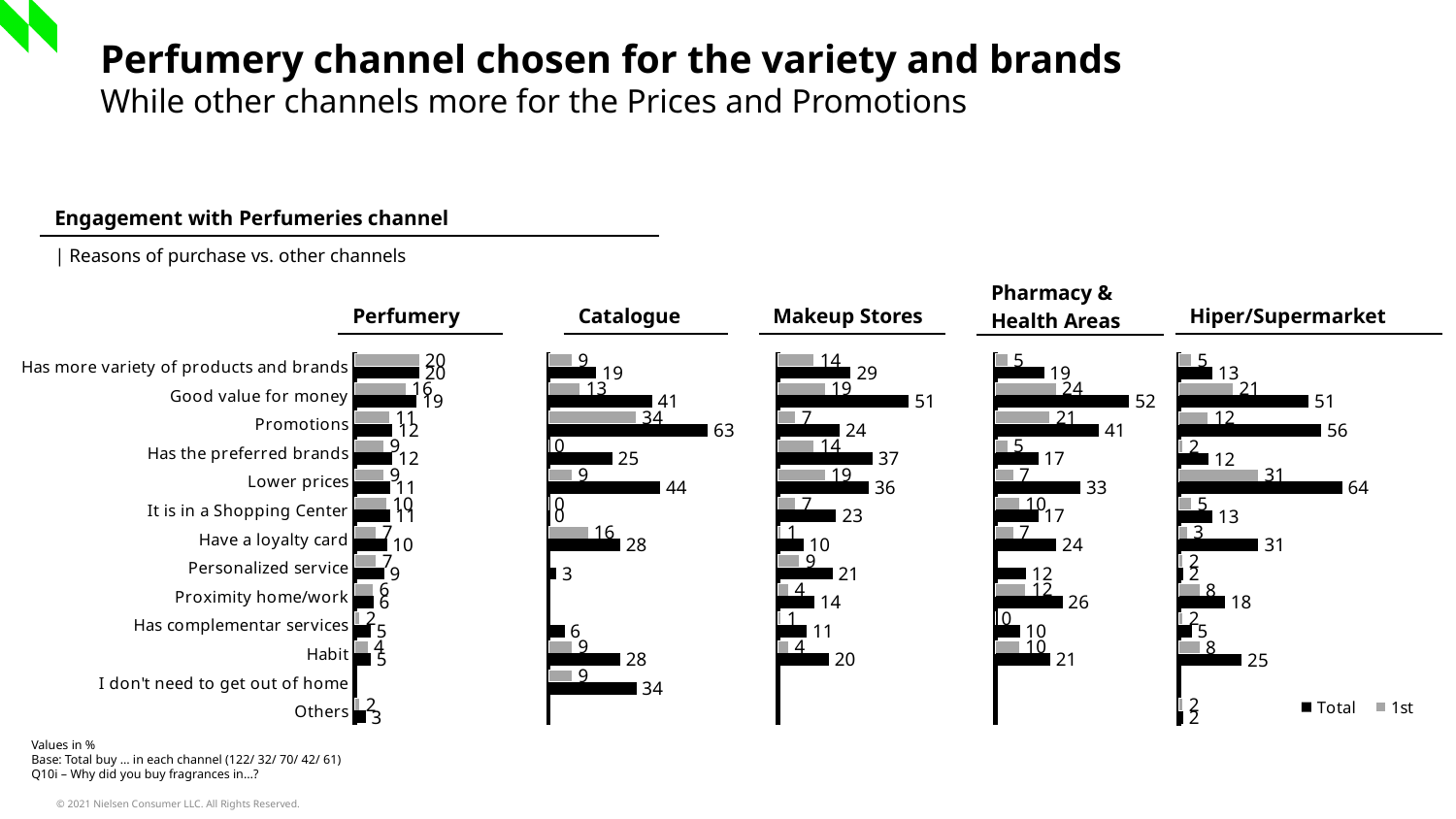
In the Pharmacy & Health Areas chart, what is the Total value for Lower prices? 33 In the Catalogue chart, what is the Total value for Promotions? 63 In the Perfumery chart, what is the Total value for "Has more variety of products and brands"? 20 In the Makeup Stores chart, what is the 1st value for Good value for money? 19 In the Hiper/Supermarket chart, which reason has the highest Total value? Lower prices In the Hiper/Supermarket chart, what is the Total value for Lower prices? 64 How many channel charts are shown on the slide? 5 In the Pharmacy & Health Areas chart, which reason has the highest Total value? Good value for money What kind of chart is used for the Perfumery data? Bar chart How many series does the legend list? 2 In the Makeup Stores chart, which is larger: the Total value for Good value for money or the Total value for Has the preferred brands? Good value for money In the Catalogue chart, what is the difference between the Total and 1st values for Promotions? 29